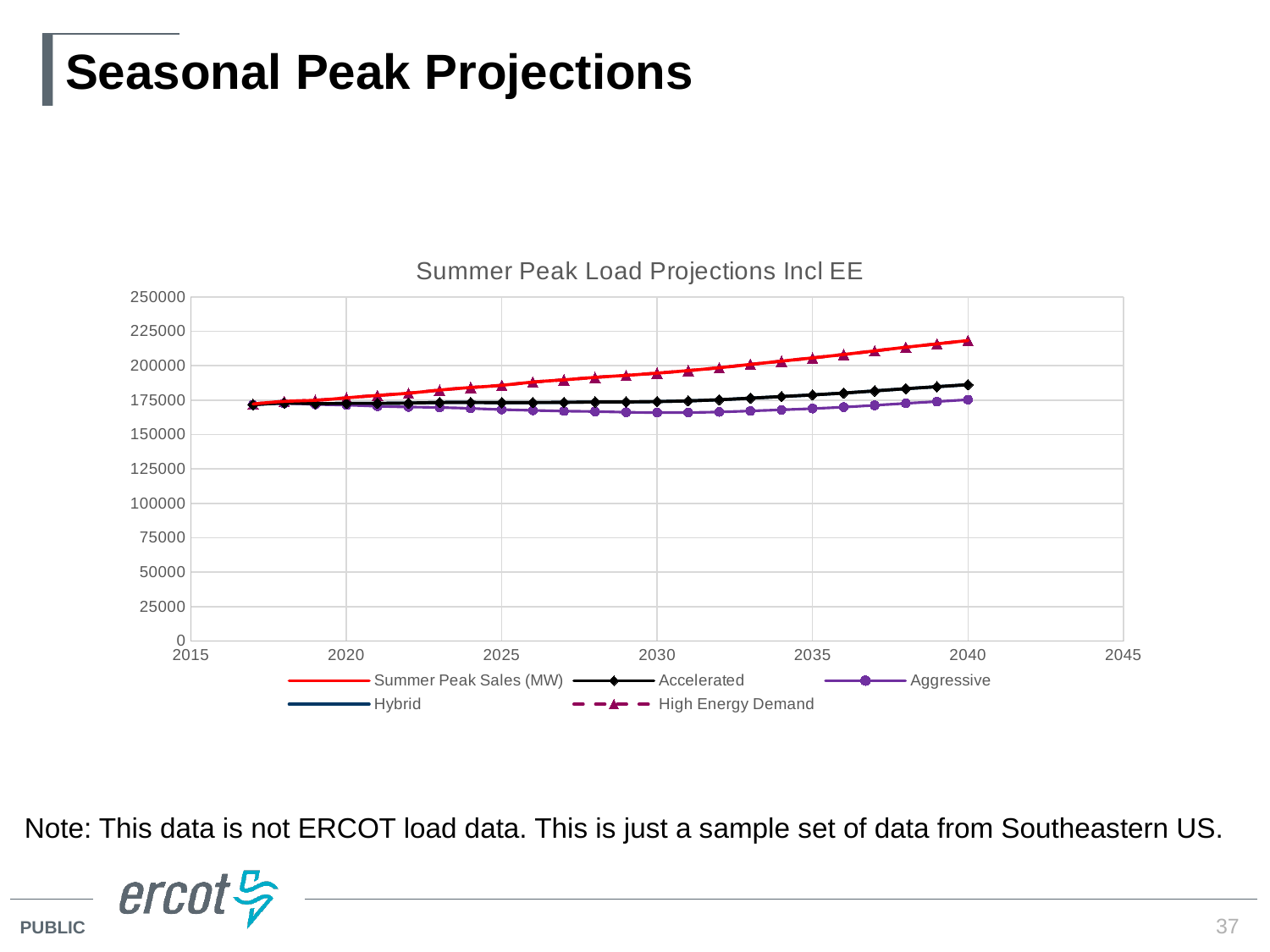
How many series does the chart legend list? 5 What is the title of the chart? Summer Peak Load Projections Incl EE Is the value for Accelerated in 2040 greater or less than 175000? greater Does the Summer Peak Sales (MW) line rise or fall from 2017 to 2040? rise What colour is the Summer Peak Sales (MW) line? red Which series has the lowest value in 2040? Aggressive Is the value for Accelerated in 2030 greater or less than 200000? less Is the value for Summer Peak Sales (MW) in 2040 greater or less than 200000? greater In 2035, which is larger: Accelerated or Aggressive? Accelerated In 2040, which is larger: Summer Peak Sales (MW) or Accelerated? Summer Peak Sales (MW) What kind of chart is shown on the slide? line chart